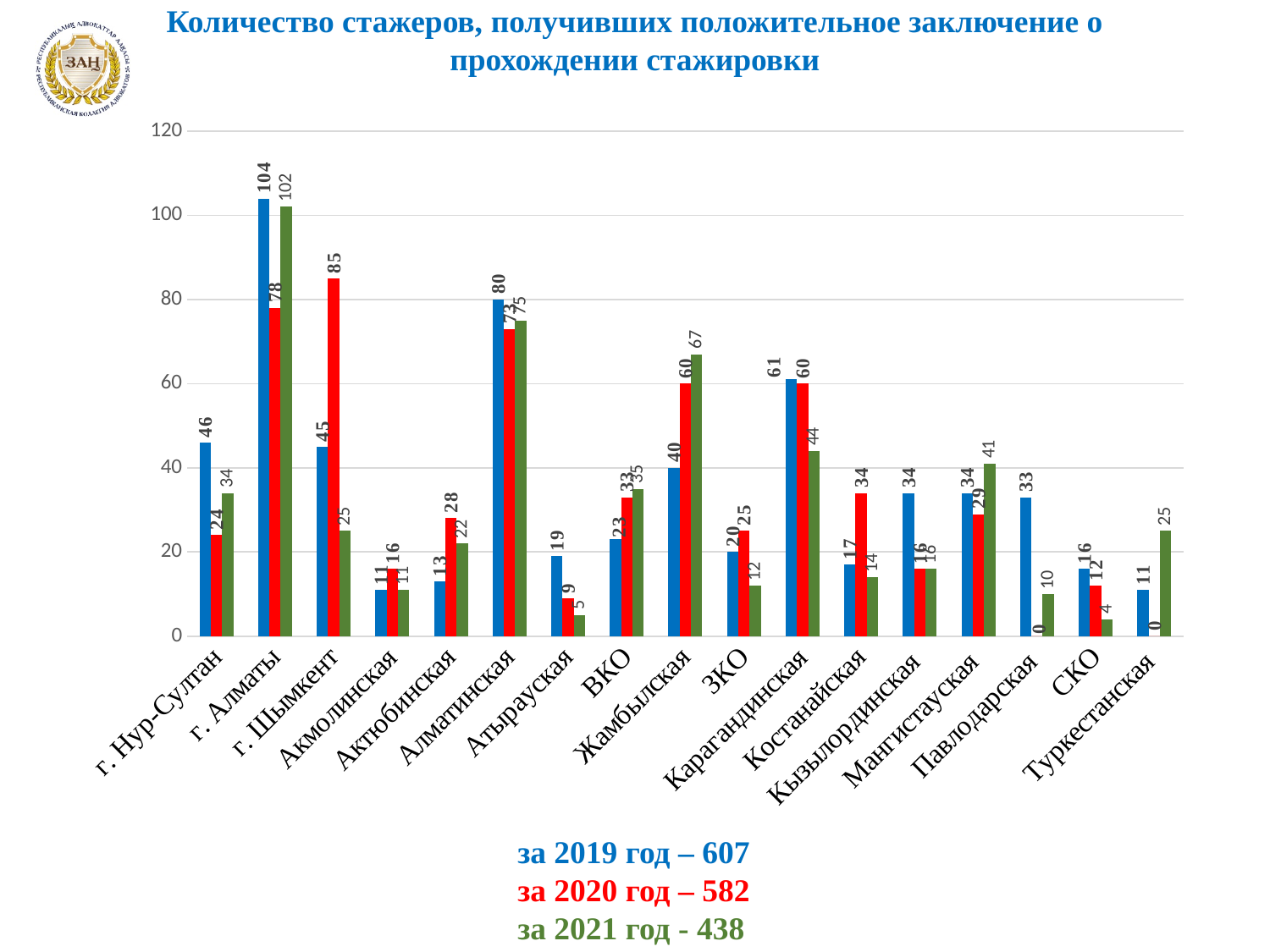
Which region has the lowest green (2021) bar? СКО Is the value of the red (2020) bar for Алматинская greater or less than 60? greater Which is larger for Карагандинская: the blue (2019) bar or the green (2021) bar? the blue (2019) bar What is the value of the green (2021) bar for Жамбылская? 67 Which region has the highest blue (2019) bar? г. Алматы What is the value of the red (2020) bar for г. Шымкент? 85 How many regions (categories) are shown on the x axis of the chart? 17 What type of chart is shown on the slide? bar chart What is the value of the red (2020) bar for Павлодарская? 0 What is the value of the blue (2019) bar for г. Алматы? 104 According to the text below the chart, what is the total for 2021? 438 What is the difference between the blue (2019) and red (2020) bars for г. Нур-Султан? 22